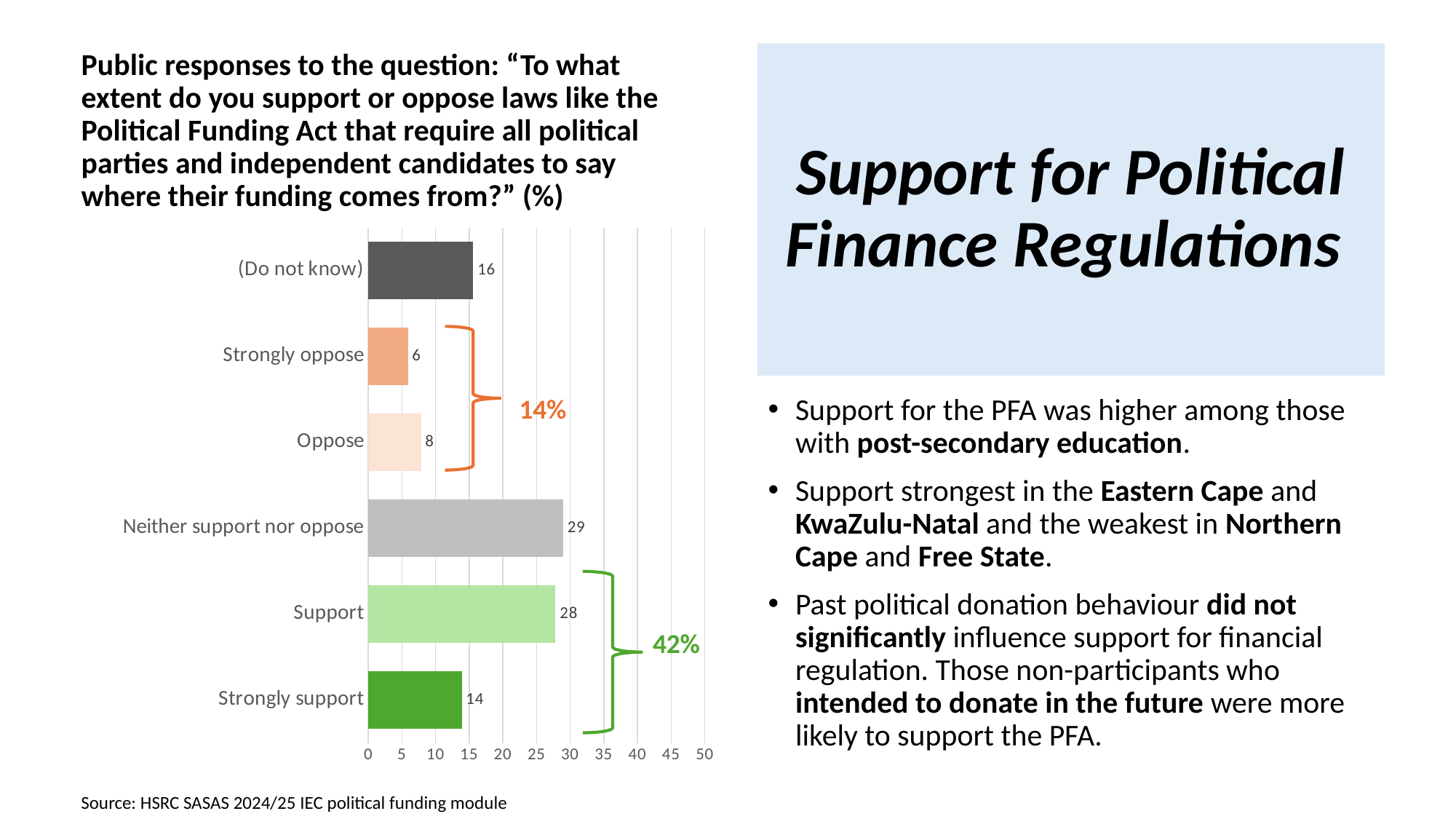
Which category has the highest value? Neither support nor oppose What is the value for "(Do not know)"? 16 What combined percentage is shown by the bracket grouping "Strongly oppose" and "Oppose"? 14% How many categories are shown in the chart? 6 What is the difference between the values for "Support" and "Strongly support"? 14 What is the value for "Neither support nor oppose"? 29 Which is larger, the value for "Oppose" or the value for "Strongly oppose"? Oppose What is the value for "Strongly support"? 14 Which category has the lowest value? Strongly oppose What kind of chart is shown on the slide? Bar chart What combined percentage is shown by the bracket grouping "Support" and "Strongly support"? 42% Is the value for "Support" greater or less than 25? greater